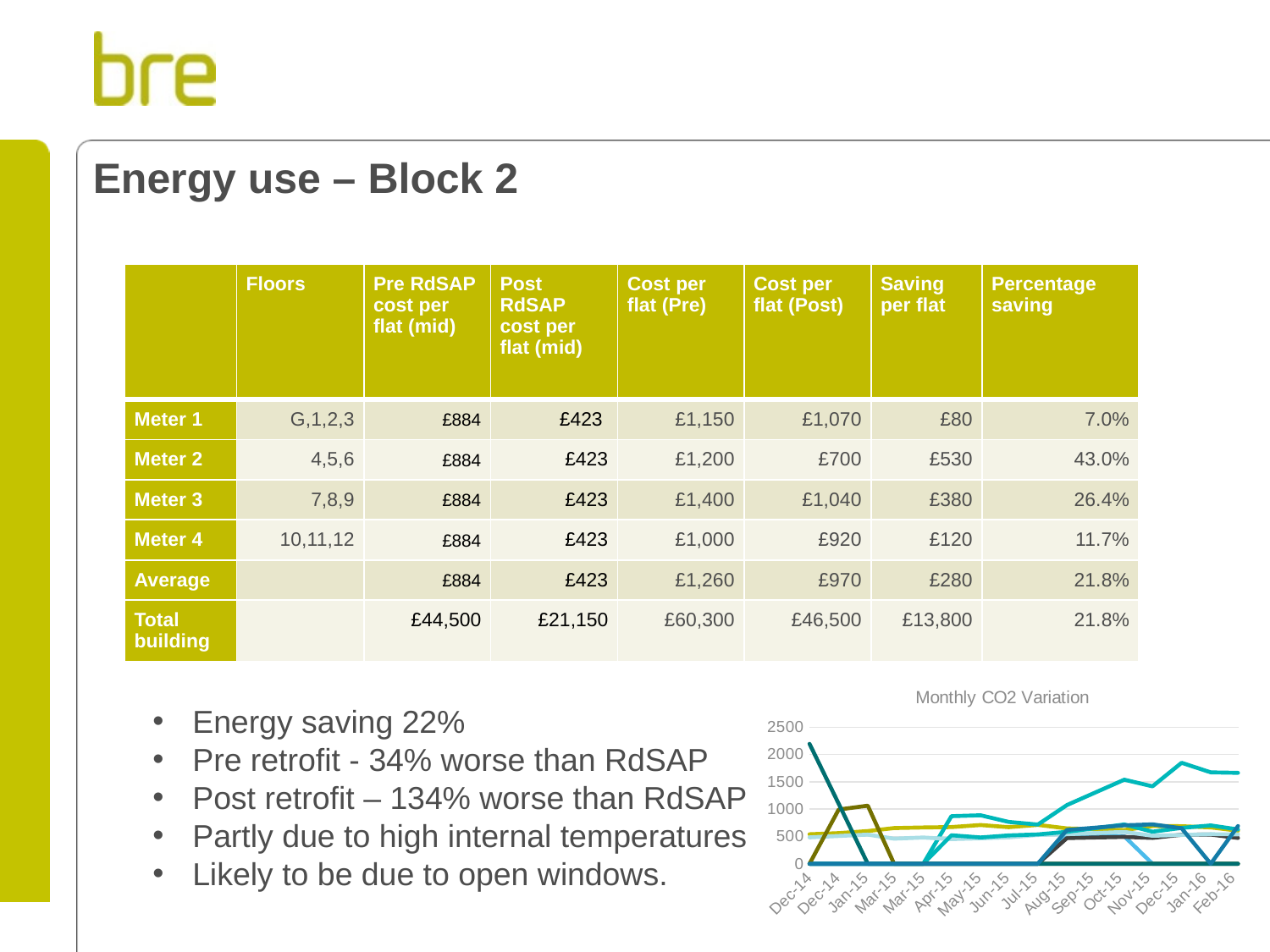
What is the highest value shown on the y axis of the Monthly CO2 Variation chart? 2500 How many month labels are shown along the x axis of the Monthly CO2 Variation chart? 16 In the Monthly CO2 Variation chart, is the highest value plotted at the first Dec-14 point greater or less than 2000? greater What kind of chart is shown at the bottom right of the slide? line chart In the Monthly CO2 Variation chart, is the highest value plotted at Jan-15 greater or less than 500? greater In the Monthly CO2 Variation chart, is the highest value plotted at Jan-16 greater or less than 1500? greater In the Monthly CO2 Variation chart, does the line that reaches its peak at Jan-16 rise or fall between Jul-15 and Jan-16? rise What is the title of the chart on the slide? Monthly CO2 Variation In the Monthly CO2 Variation chart, does the line that starts above 2000 at Dec-14 rise or fall between Dec-14 and Jan-15? fall